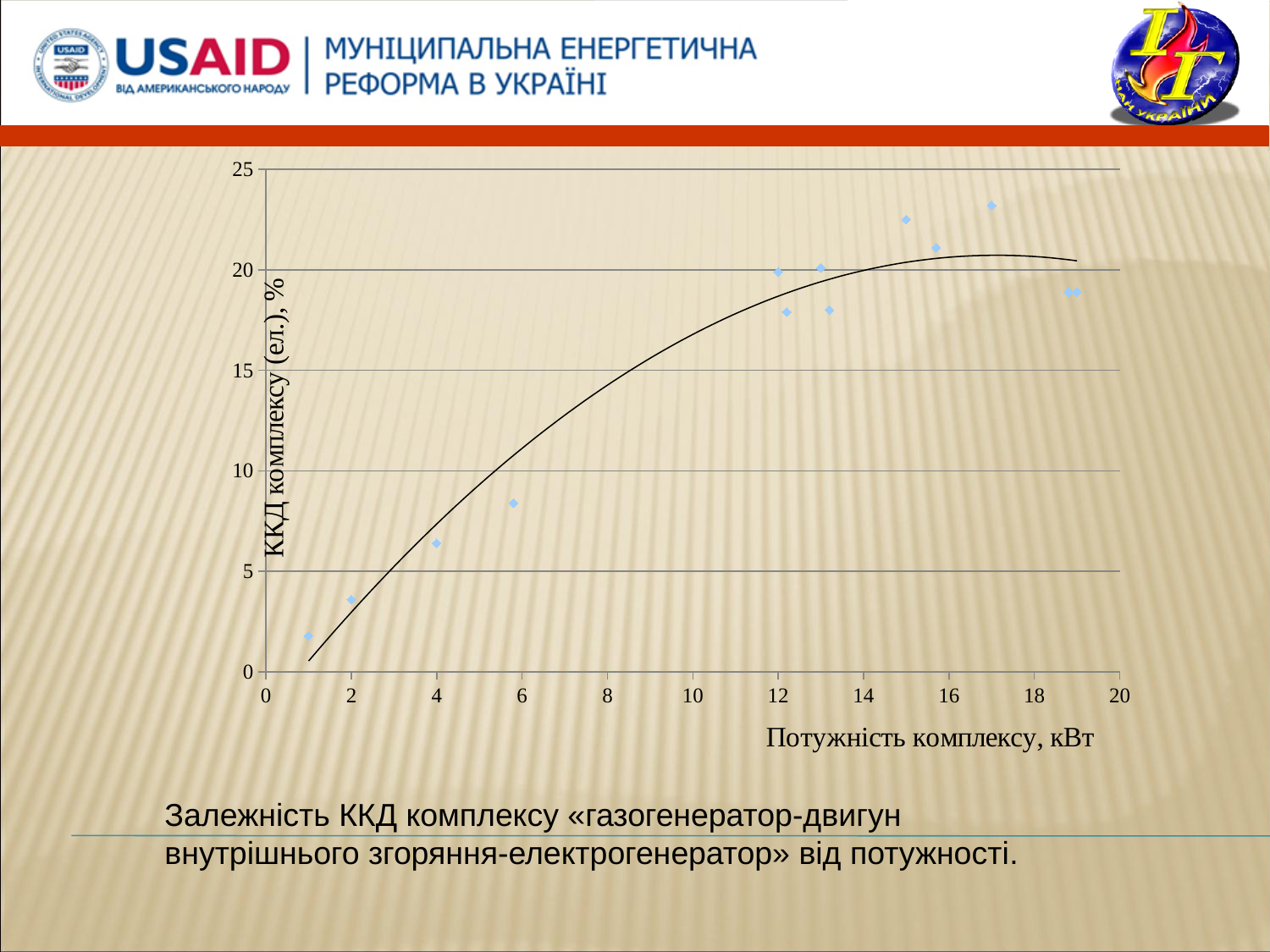
Which plotted point has the lowest efficiency value? The point at about 1 kW What is the title of the horizontal axis? Потужність комплексу, кВт Is the efficiency value for the point at about 1 kW greater or less than 5? less Which plotted point has the highest efficiency value? The point at about 17 kW What kind of chart is shown on the slide? Scatter chart Is the efficiency value for the point at about 6 kW greater or less than 10? less What is the title of the vertical axis? ККД комплексу (ел.), % Is the efficiency value for the point at about 4 kW greater or less than 5? greater Which point has the higher efficiency: the one at about 6 kW or the one at about 17 kW? The one at about 17 kW Do the plotted efficiency values generally rise or fall as the power (Потужність комплексу) increases from 0 to about 17 kW? Rise